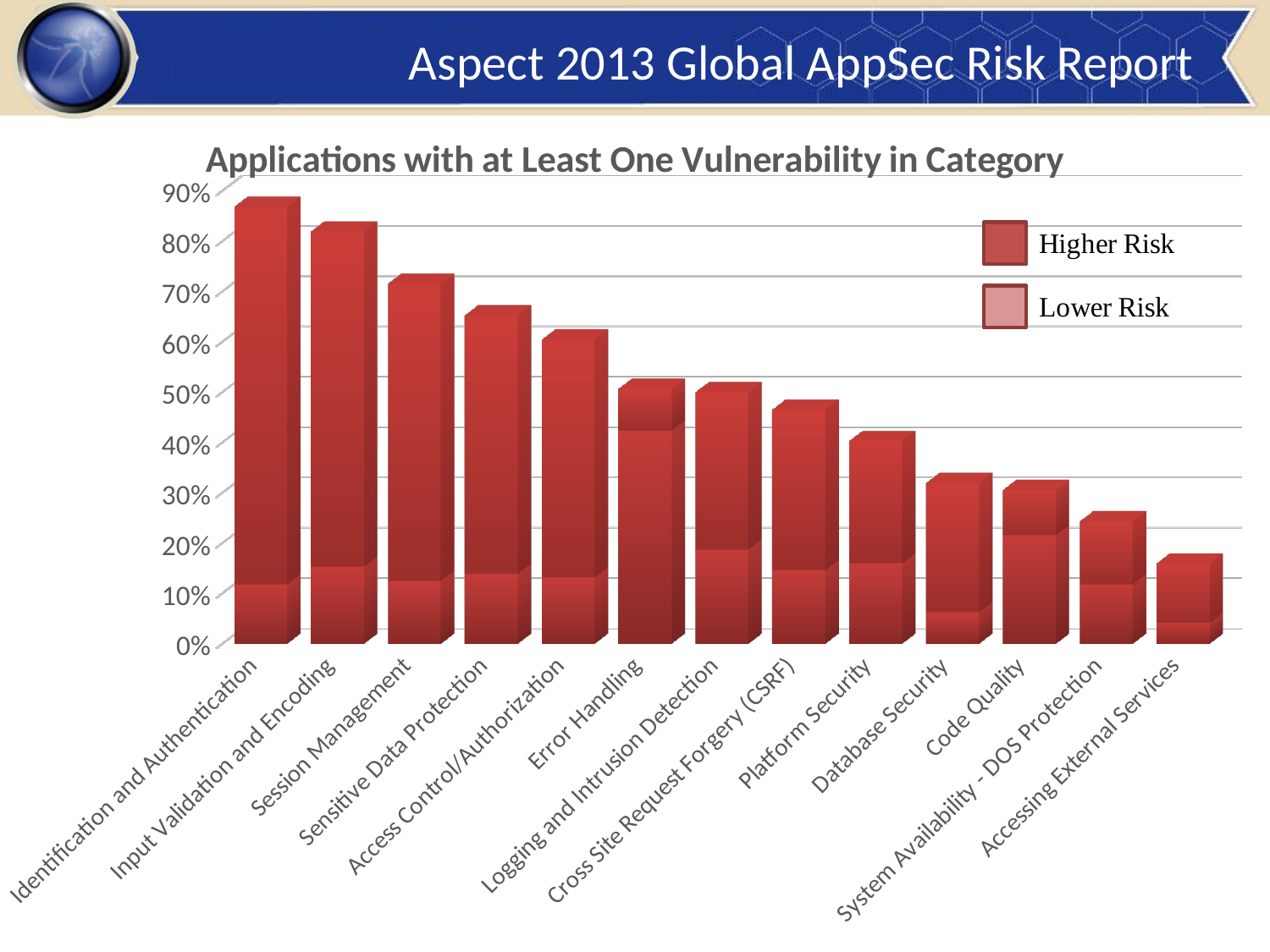
What is the title of the chart? Applications with at Least One Vulnerability in Category How many entries does the chart's legend list? 2 Do the bar values rise or fall moving from left to right along the x axis? Fall Which category has the lowest value in the chart? Accessing External Services Is the value for Platform Security greater or less than 50%? less What type of chart is shown on the slide? Bar chart Which category has the highest value in the chart? Identification and Authentication Is the value for Accessing External Services greater or less than 20%? less Is the value for Session Management greater or less than 60%? greater How many categories are shown on the x axis of the chart? 13 Which has a larger value, Session Management or Code Quality? Session Management